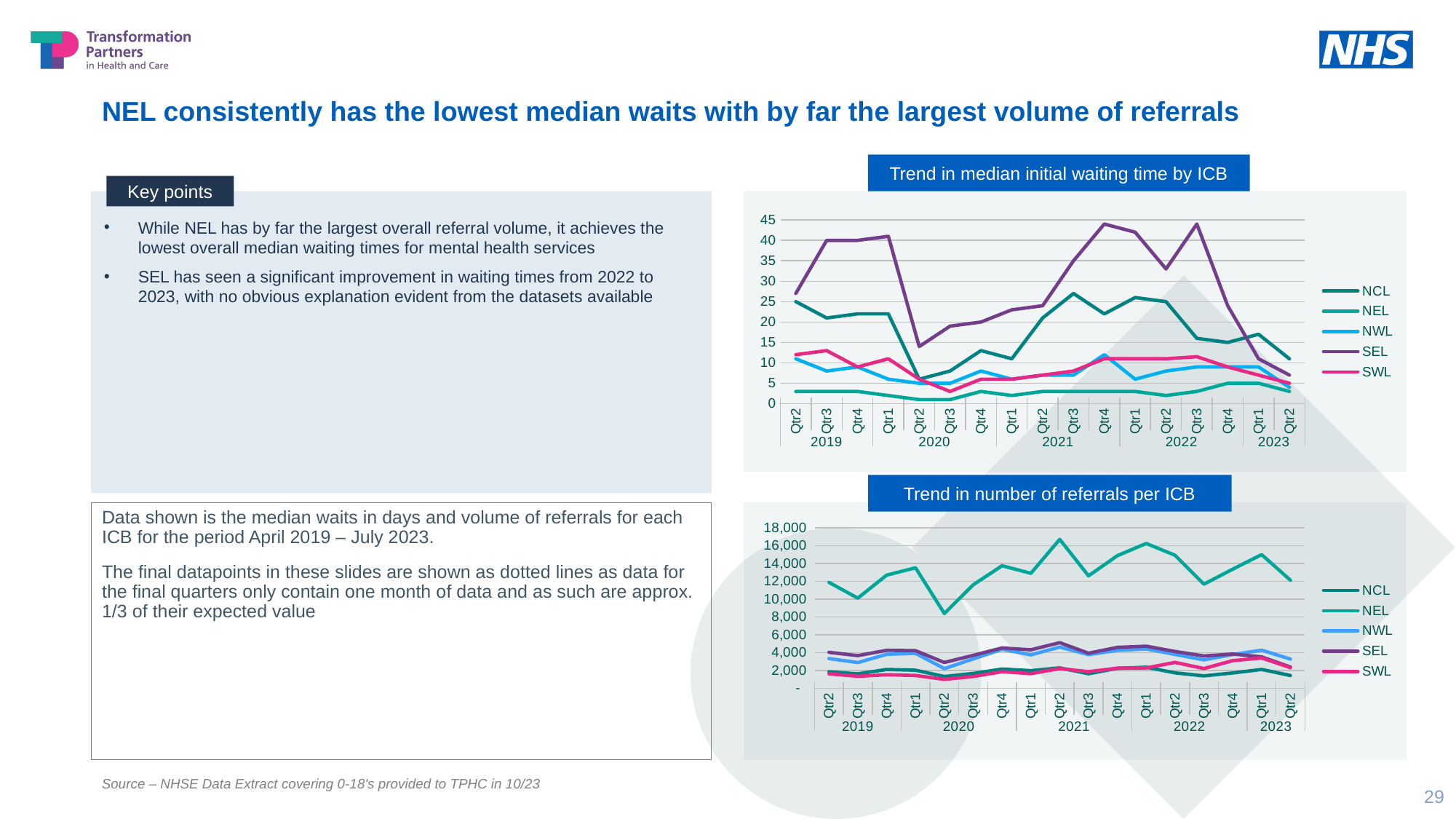
What kind of chart is the 'Trend in median initial waiting time by ICB' chart? line chart In the 'Trend in number of referrals per ICB' chart, which ICB has the highest number of referrals? NEL In the 'Trend in median initial waiting time by ICB' chart, which ICB has the lowest median waiting time across the period? NEL In the 'Trend in median initial waiting time by ICB' chart, which ICB reaches the highest median waiting time? SEL How many series does the legend of the 'Trend in number of referrals per ICB' chart list? 5 In the 'Trend in median initial waiting time by ICB' chart, is the value for NEL in 2021 Qtr3 greater or less than 5? less In the 'Trend in median initial waiting time by ICB' chart, is the value for SEL in 2019 Qtr3 greater or less than 35? greater How many quarterly points are plotted along the x axis of the 'Trend in median initial waiting time by ICB' chart? 17 What is the title of the lower chart on the slide? Trend in number of referrals per ICB In the 'Trend in number of referrals per ICB' chart, is the value for NEL in 2020 Qtr2 greater or less than 10,000? less In the 'Trend in number of referrals per ICB' chart, which is larger in 2021 Qtr2: NEL or SEL? NEL